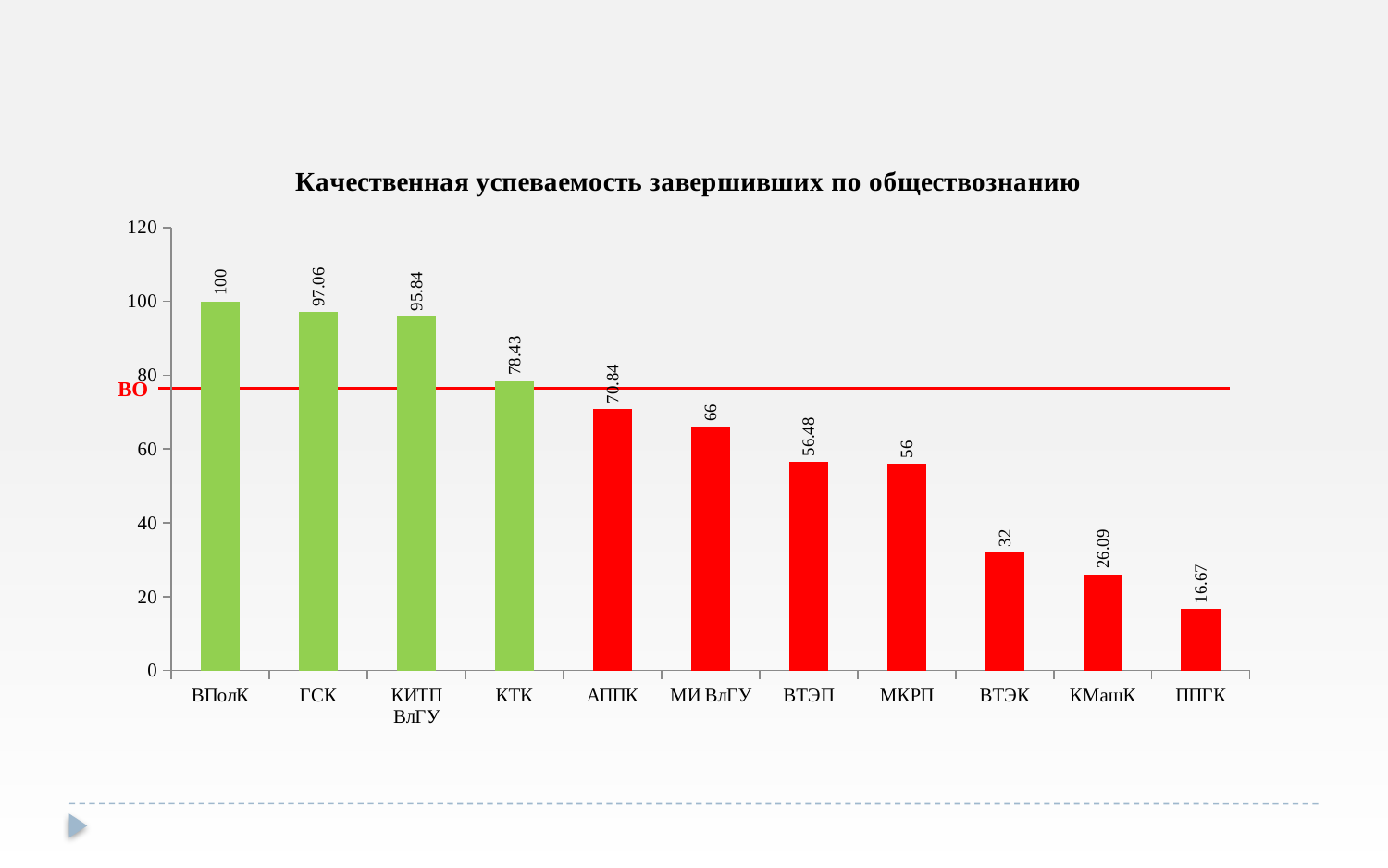
Do the values rise or fall from left to right along the x axis? fall What is the value for ВПолК? 100 What is the difference between the values for ГСК and КИТП ВлГУ? 1.22 What is the value for ВТЭП? 56.48 Which category has the lowest value? ППГК What is the value for ППГК? 16.67 Which category has the highest value? ВПолК How many categories are shown on the x axis? 11 Is the value for АППК greater or less than 80? less What kind of chart is shown on the slide? bar chart Which is larger, the value for МИ ВлГУ or the value for МКРП? МИ ВлГУ What is the value for КТК? 78.43